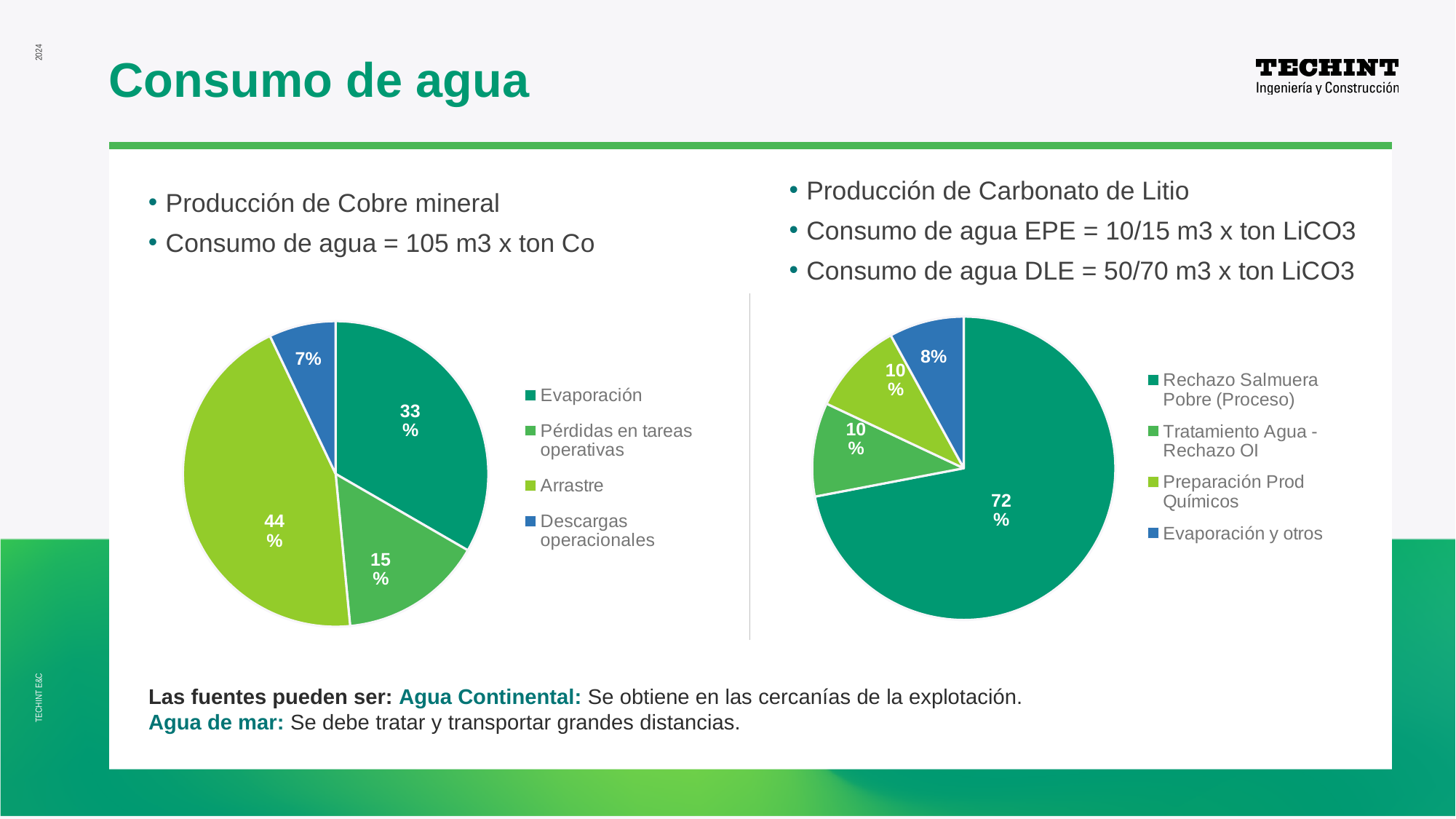
In the left pie chart, which category has the smallest share? Descargas operacionales In the left pie chart, which category has the largest share? Arrastre In the right pie chart, which is larger: Tratamiento Agua - Rechazo OI or Evaporación y otros? Tratamiento Agua - Rechazo OI In the left pie chart, how many categories does the legend list? 4 In the right pie chart, what share does Evaporación y otros have? 8% What kind of chart is the right chart on the slide? Pie chart In the left pie chart, what share does Arrastre have? 44% In the right pie chart, which category has the largest share? Rechazo Salmuera Pobre (Proceso) In the right pie chart, what share does Rechazo Salmuera Pobre (Proceso) have? 72% In the right pie chart, what colour is the Evaporación y otros slice? Blue In the left pie chart, what share does Evaporación have? 33% In the left pie chart, what is the difference between the shares of Arrastre and Evaporación? 11%